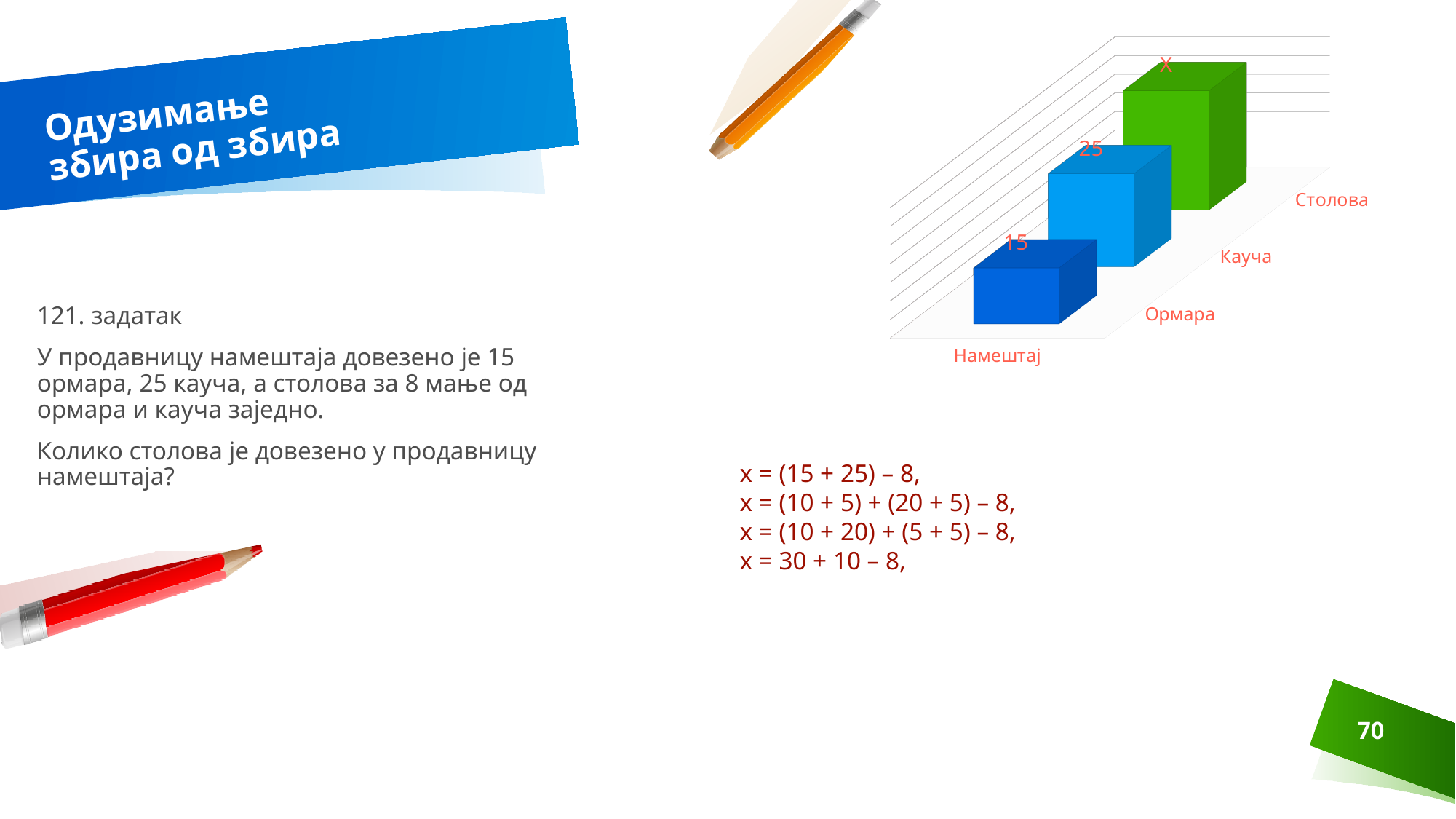
What is the axis label shown below the categories in the chart? Намештај What label is shown on the bar for Столова in the chart? x What is the difference between the values for Кауча and Ормара in the chart? 10 Which category has the tallest bar in the chart? Столова Which is larger in the chart, the value for Кауча or the value for Ормара? Кауча Do the bars rise or fall from Ормара to Столова in the chart? rise What value is shown for Кауча in the chart? 25 What kind of chart is shown on the slide? bar chart What value is shown for Ормара in the chart? 15 Which category has the shortest bar in the chart? Ормара What colour is the bar for Столова in the chart? green How many categories are plotted in the chart? 3